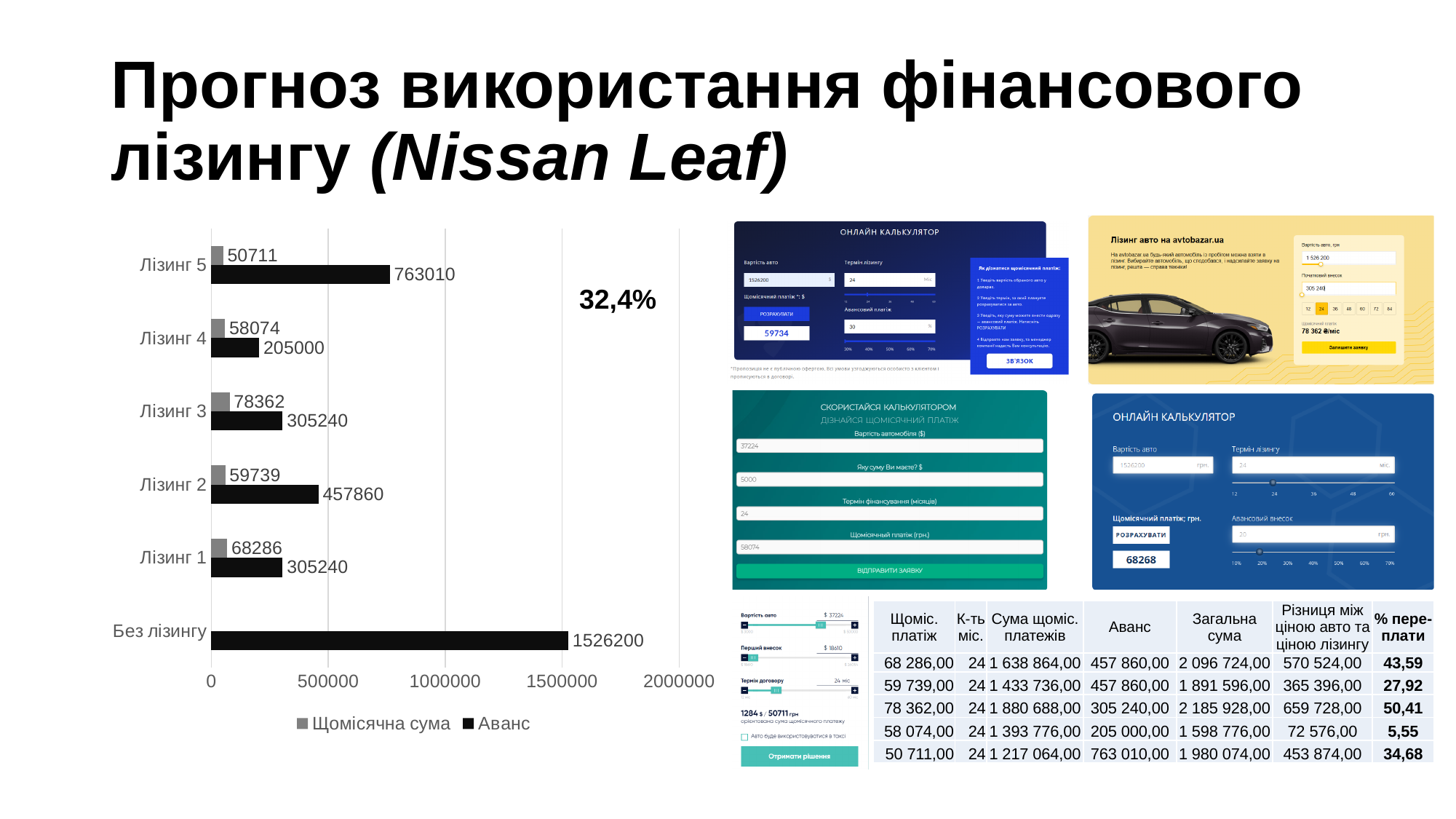
What is the Щомісячна сума value for Лізинг 3? 78362 What is the difference between the Аванс values for Лізинг 5 and Лізинг 4? 558010 Which category has the lowest Щомісячна сума value? Лізинг 5 What kind of chart is shown on the left of the slide? bar chart Which is larger: the Щомісячна сума for Лізинг 1 or for Лізинг 2? Лізинг 1 Which category has the lowest Аванс value? Лізинг 4 Which series is shown in black in the chart legend? Аванс How many categories are shown on the chart's vertical axis? 6 How many series does the chart legend list? 2 What is the Аванс value for Лізинг 5? 763010 Which category has the highest Аванс value? Без лізингу What is the Аванс value for Без лізингу? 1526200